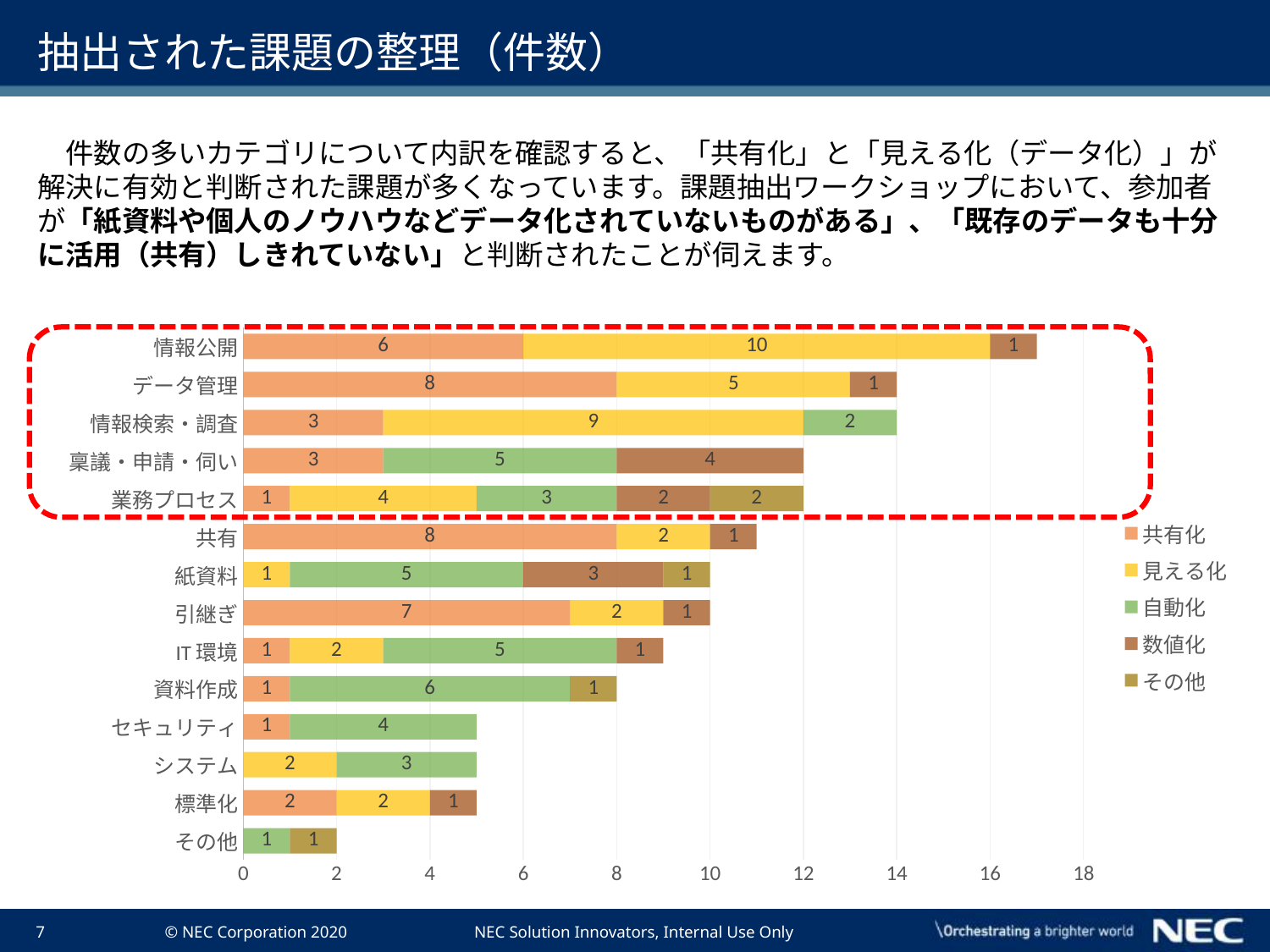
What is the 見える化 value for 情報公開? 10 What is the 自動化 value for 資料作成? 6 What is the difference between the 共有化 values for 引継ぎ and 情報検索・調査? 4 What is the 数値化 value for 稟議・申請・伺い? 4 Which category has the lowest total? その他 Which category has the highest total? 情報公開 How many series does the legend list? 5 What is the total of the stacked bar for 情報公開? 17 Which is larger, the 自動化 value for 紙資料 or the 自動化 value for セキュリティ? 紙資料 What is the total of the stacked bar for 業務プロセス? 12 What is the 共有化 value for データ管理? 8 How many categories are shown on the chart? 14